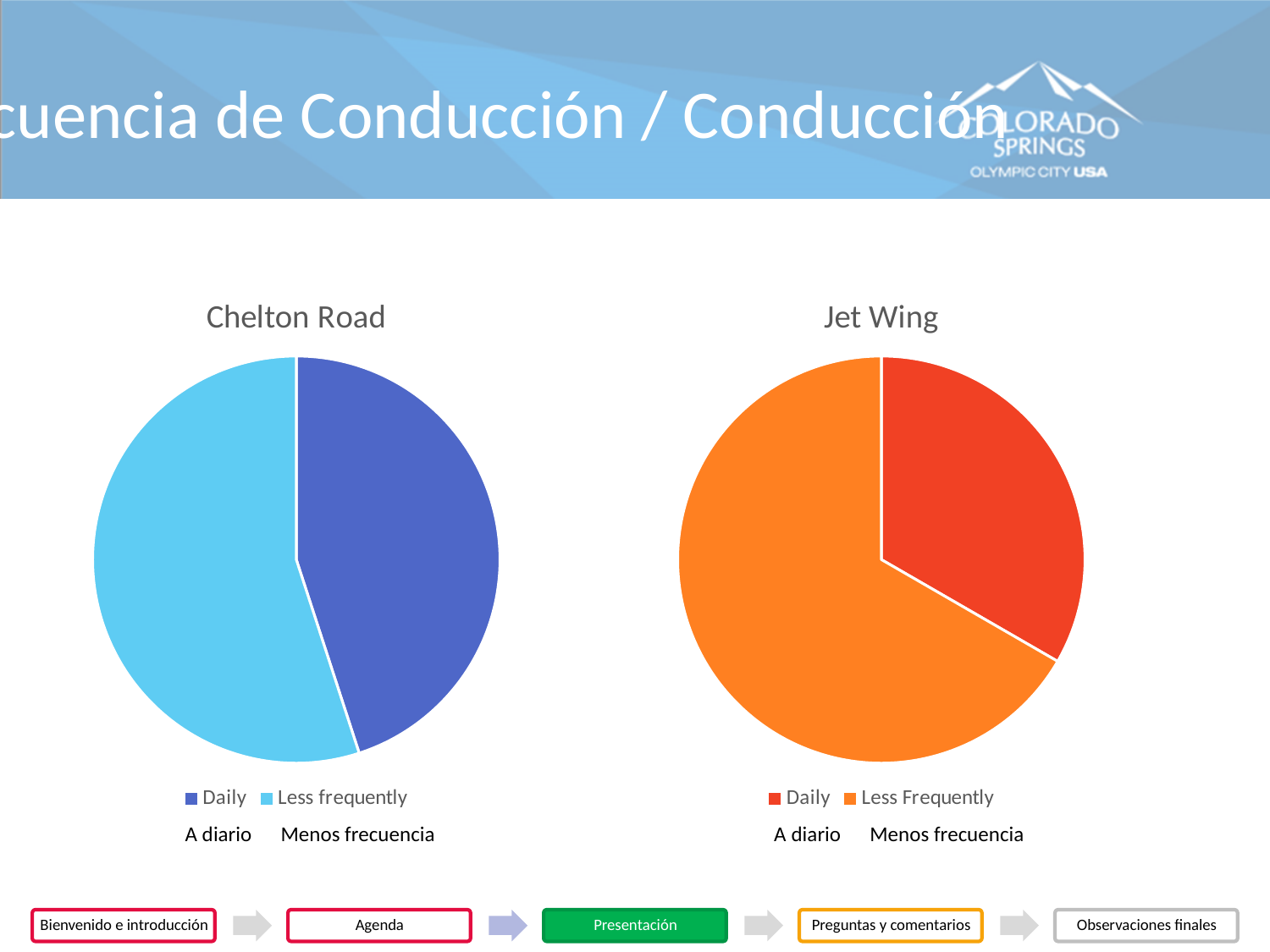
What kind of chart is the Jet Wing chart? pie chart In the Jet Wing chart, what colour is the Daily slice? red How many entries does the legend of the Jet Wing chart list? 2 How many slices does the Chelton Road pie chart have? 2 How many pie charts are shown on the slide? 2 How many slices does the Jet Wing pie chart have? 2 In the Jet Wing chart, which slice is the smallest? Daily In the Jet Wing chart, which slice is larger, Daily or Less Frequently? Less Frequently In the Chelton Road chart, which slice is larger, Daily or Less frequently? Less frequently What is the title of the pie chart on the left of the slide? Chelton Road What kind of chart is the Chelton Road chart? pie chart In the Jet Wing chart, which slice is the largest? Less Frequently